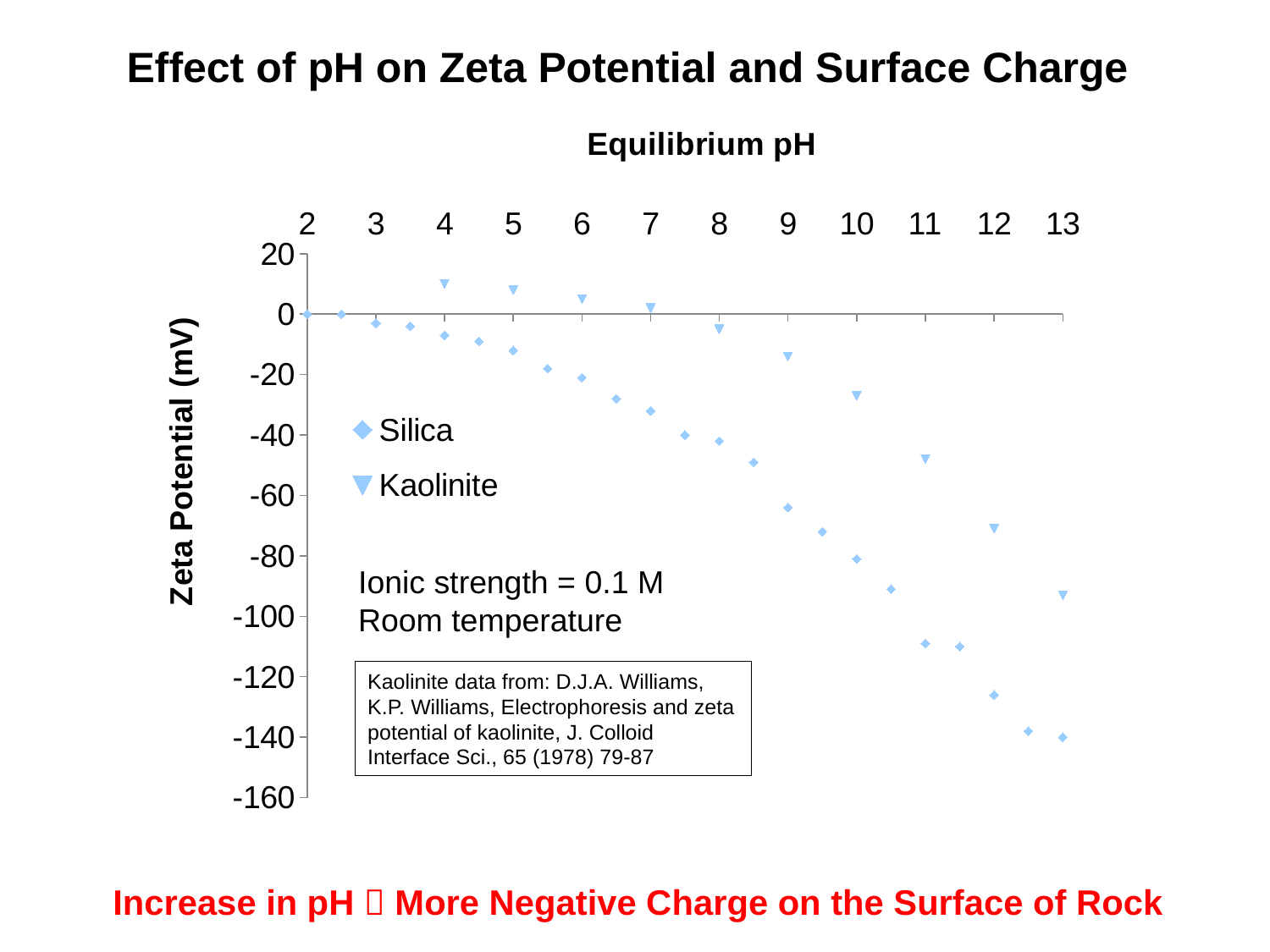
Which series reaches the lowest zeta potential on the chart? Silica Is the zeta potential for Silica at pH 10 greater or less than -60? less What are the two series named in the legend? Silica and Kaolinite Is the zeta potential for Silica at pH 7 greater or less than -40? greater How many series does the legend list? 2 Is the zeta potential for Kaolinite at pH 4 greater or less than 0? greater Do the Silica zeta potential values rise or fall as pH increases? Fall What is the title of the vertical axis? Zeta Potential (mV) At pH 12, which series has the higher (less negative) zeta potential, Silica or Kaolinite? Kaolinite What kind of chart is shown on the slide? Scatter chart